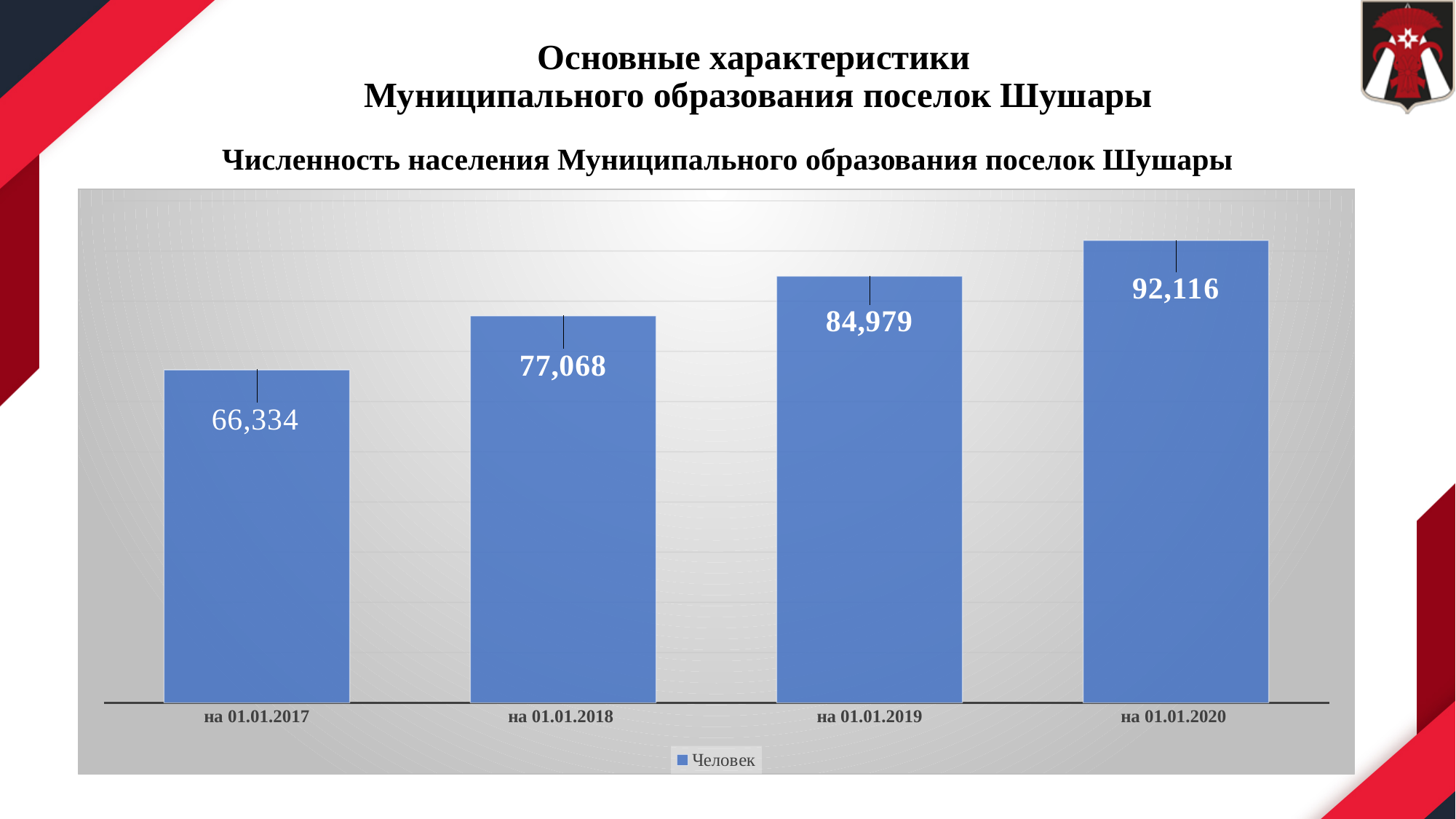
What kind of chart is shown on the slide? Bar chart What is the difference between the values for на 01.01.2018 and на 01.01.2017? 10,734 Do the values rise or fall from на 01.01.2017 to на 01.01.2020? Rise What is the population value shown for на 01.01.2017? 66,334 Which date has the lowest population value? на 01.01.2017 How many bars are shown in the chart? 4 Which date has the highest population value? на 01.01.2020 What is the population value shown for на 01.01.2020? 92,116 What is the difference between the values for на 01.01.2020 and на 01.01.2017? 25,782 Which is larger, the value for на 01.01.2019 or the value for на 01.01.2018? на 01.01.2019 What is the population value shown for на 01.01.2019? 84,979 What is the population value shown for на 01.01.2018? 77,068